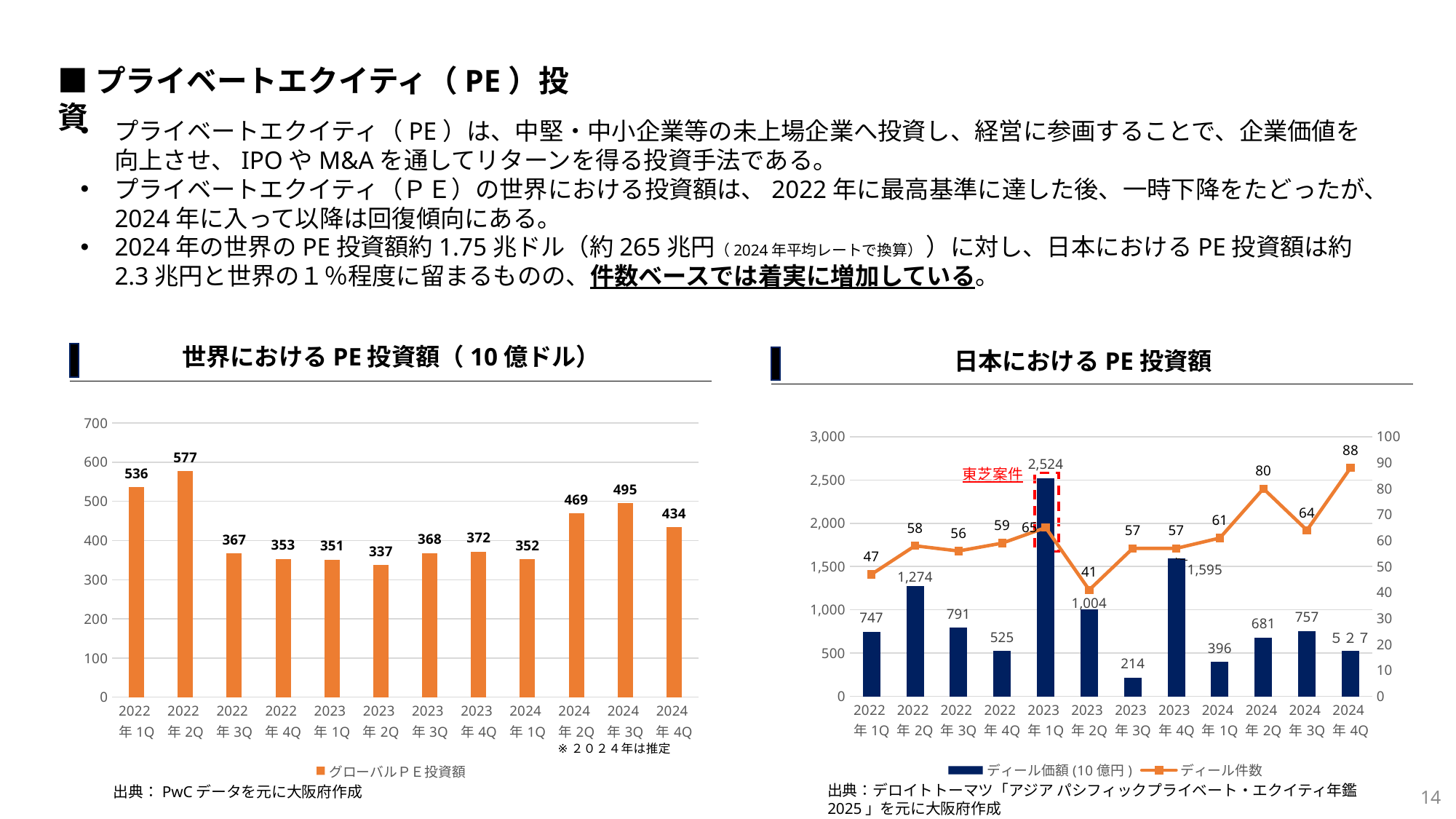
In the chart titled 日本におけるPE投資額, what is the ディール価額 for 2023年1Q? 2,524 In the chart titled 日本におけるPE投資額, which quarter is marked with the red dashed box labelled 東芝案件? 2023年1Q In the chart titled 日本におけるPE投資額, what is the ディール件数 for 2024年4Q? 88 In the chart titled 日本におけるPE投資額, how many series does the legend list? 2 In the chart titled 世界におけるPE投資額（10億ドル）, which quarter has the lowest value? 2023年2Q In the chart titled 日本におけるPE投資額, which is larger, the ディール価額 for 2022年2Q or for 2023年4Q? 2023年4Q In the chart titled 世界におけるPE投資額（10億ドル）, what is the value for 2022年2Q? 577 In the chart titled 世界におけるPE投資額（10億ドル）, how many quarters are plotted? 12 In the chart titled 世界におけるPE投資額（10億ドル）, what is the difference between 2024年3Q and 2024年4Q? 61 In the chart titled 世界におけるPE投資額（10億ドル）, what kind of chart is shown? Bar chart In the chart titled 日本におけるPE投資額, which quarter has the lowest ディール価額? 2023年3Q In the chart titled 日本におけるPE投資額, what is the difference in ディール件数 between 2024年2Q and 2024年3Q? 16